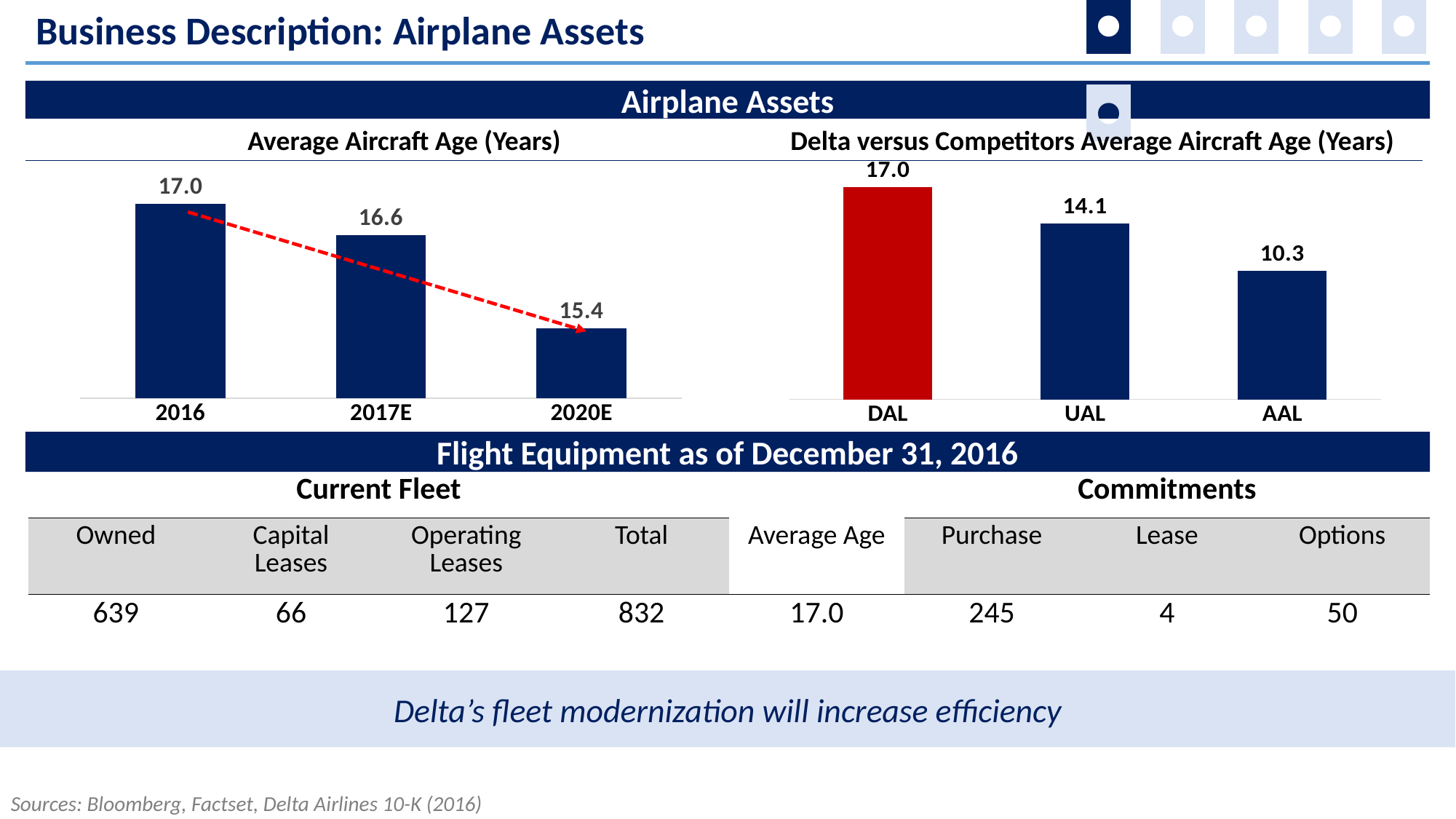
In the 'Average Aircraft Age (Years)' chart, which category has the lowest value? 2020E In the 'Delta versus Competitors Average Aircraft Age (Years)' chart, which bar is coloured red? DAL In the 'Average Aircraft Age (Years)' chart, what is the value for 2016? 17.0 In the 'Average Aircraft Age (Years)' chart, what is the difference between the 2016 and 2020E values? 1.6 In the 'Delta versus Competitors Average Aircraft Age (Years)' chart, which category has the highest value? DAL What type of chart is the 'Delta versus Competitors Average Aircraft Age (Years)' chart? bar chart In the 'Delta versus Competitors Average Aircraft Age (Years)' chart, which category has the lowest value? AAL In the 'Delta versus Competitors Average Aircraft Age (Years)' chart, what is the value for UAL? 14.1 In the 'Delta versus Competitors Average Aircraft Age (Years)' chart, what is the difference between the DAL and AAL values? 6.7 In the 'Average Aircraft Age (Years)' chart, what is the value for 2020E? 15.4 How many categories are shown in the 'Average Aircraft Age (Years)' chart? 3 In the 'Average Aircraft Age (Years)' chart, do the values rise or fall from 2016 to 2020E? fall